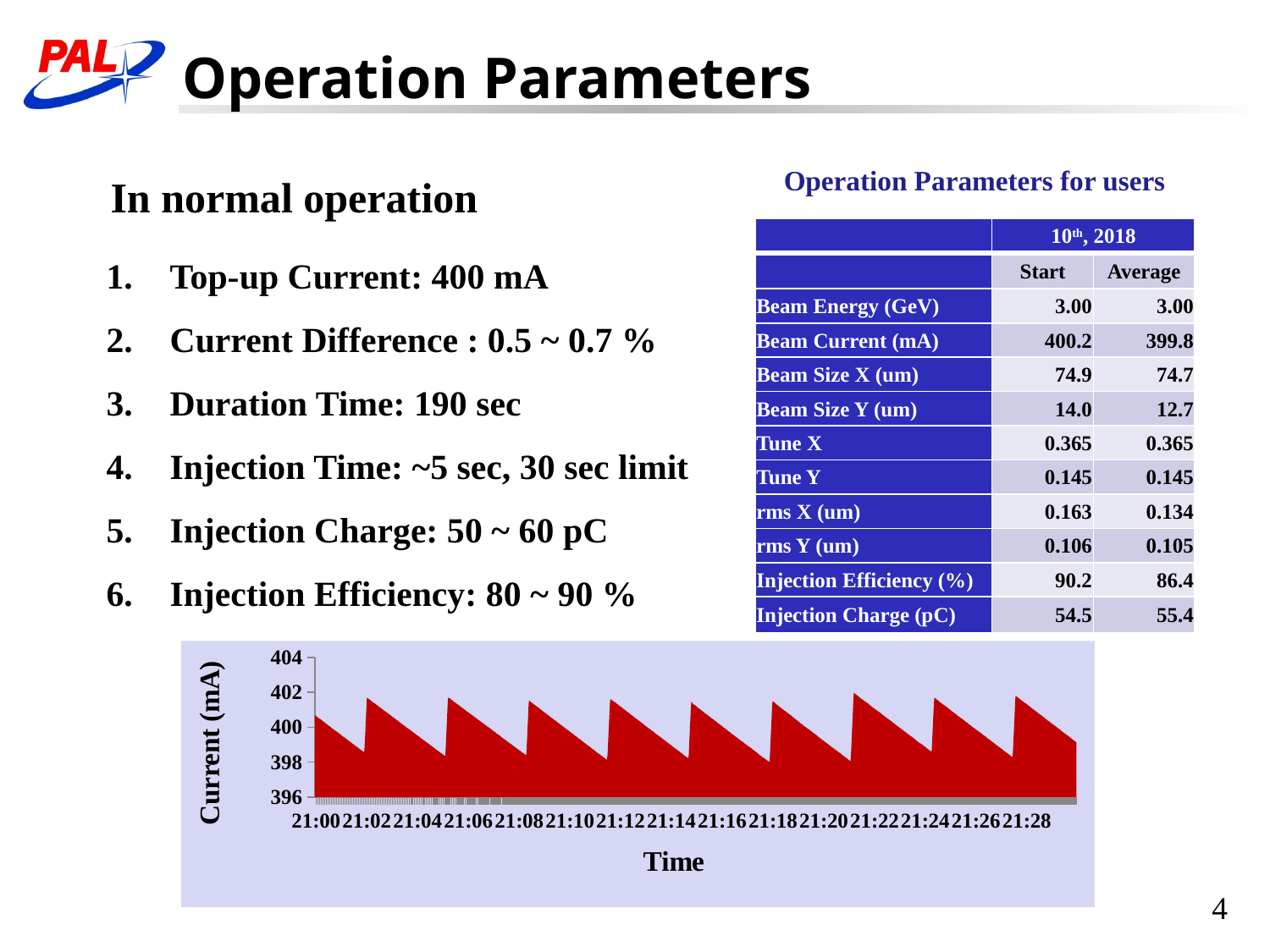
What is the label of the vertical axis of the chart? Current (mA) What is the highest value marked on the vertical axis of the chart? 404 What is the label of the horizontal axis of the chart? Time What is the lowest value marked on the vertical axis of the chart? 396 What kind of chart is shown at the bottom of the slide? area chart How many time tick labels are shown on the horizontal axis of the chart? 15 Is the lowest current shown on the chart greater or less than 396? greater What is the first time label on the horizontal axis of the chart? 21:00 Between two consecutive injections, does the current rise or fall over time? fall What is the last time label on the horizontal axis of the chart? 21:28 Is the highest current shown on the chart greater or less than 400? greater Is the highest current shown on the chart greater or less than 402? less